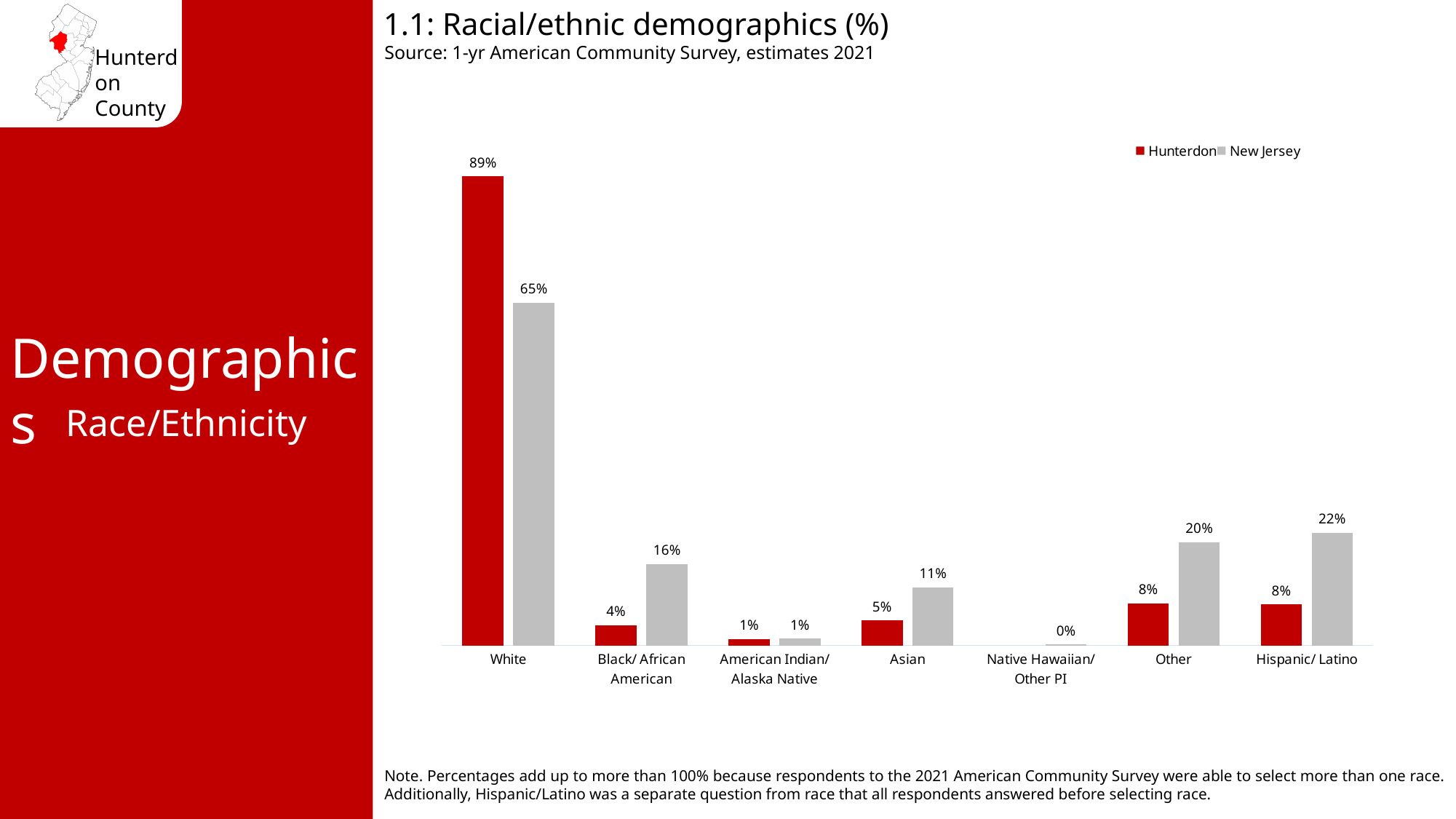
What is the New Jersey value for Hispanic/ Latino? 22% What is the difference between the New Jersey and Hunterdon values for Other? 12% How many categories are shown on the x axis? 7 Which is larger for Asian, the Hunterdon value or the New Jersey value? New Jersey How many series does the legend list? 2 What kind of chart is shown? bar chart Which category has the highest New Jersey value? White What is the difference between the Hunterdon and New Jersey values for White? 24% What is the Hunterdon value for Asian? 5% Which colour represents the Hunterdon series? red What is the New Jersey value for Black/ African American? 16% What is the Hunterdon value for White? 89%